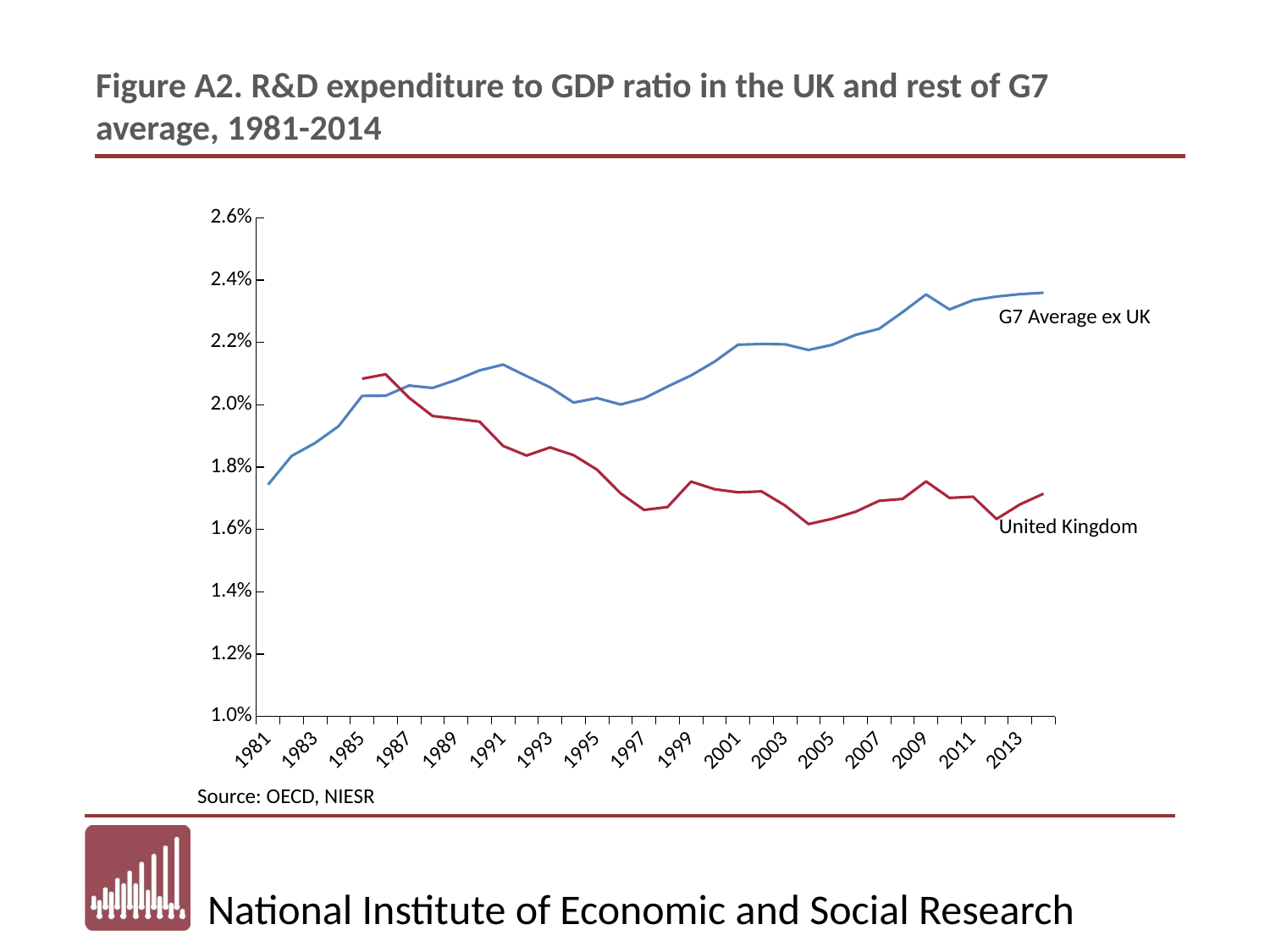
In which year is the G7 Average ex UK series at its lowest? 1981 What kind of chart is shown on the slide? Line chart What is the source cited below the chart? OECD, NIESR Does the United Kingdom series rise or fall between 1986 and 1997? fall Is the value for G7 Average ex UK in 1981 greater or less than 1.8%? less What are the names of the two series plotted on the chart? G7 Average ex UK and United Kingdom In which year is the United Kingdom series at its highest? 1986 How many series are plotted on the chart? 2 Is the value for G7 Average ex UK in 2014 greater or less than 2.2%? greater In 2014, which series has the higher value, G7 Average ex UK or United Kingdom? G7 Average ex UK Is the value for United Kingdom in 2005 greater or less than 1.8%? less